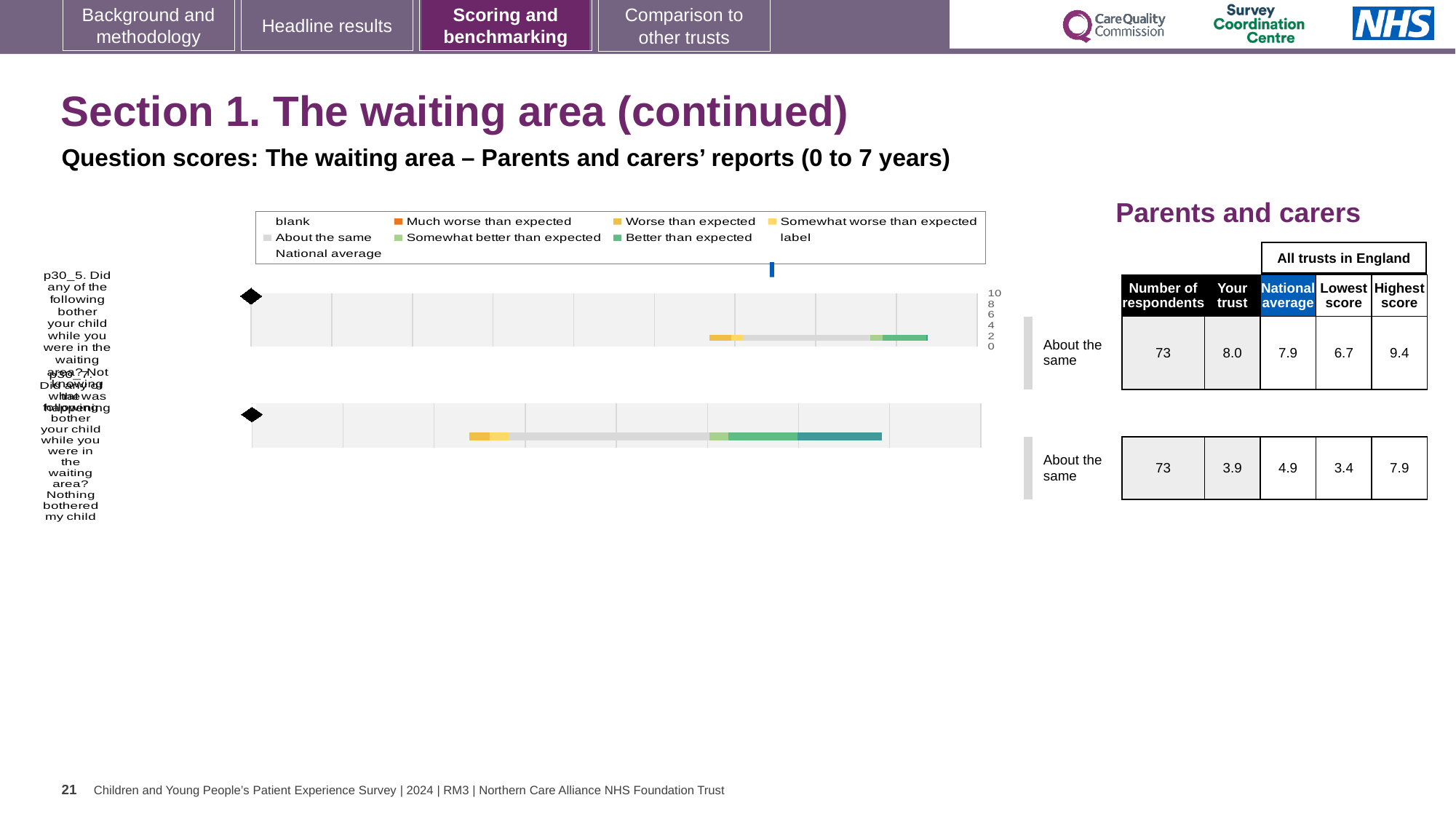
In the table, what is the highest score among all trusts in England for the first row (p30_5)? 9.4 What kind of chart is shown on the slide? bar chart In the chart legend, what colour represents 'Much worse than expected'? orange How many question bars are plotted in the chart? 2 In the table, what is the national average for the second row (p30_7)? 4.9 In the table, what is the lowest score among all trusts in England for the second row (p30_7)? 3.4 What benchmark category is given for both rows in the table? About the same For the first row (p30_5), what is the difference between the highest score and the lowest score? 2.7 What is the highest value shown on the chart's axis? 10 In the table, what is the 'Your trust' score for the first row (p30_5)? 8.0 In the table, what is the number of respondents for the first row (p30_5)? 73 For the second row (p30_7), which is larger: the 'Your trust' score or the national average? National average